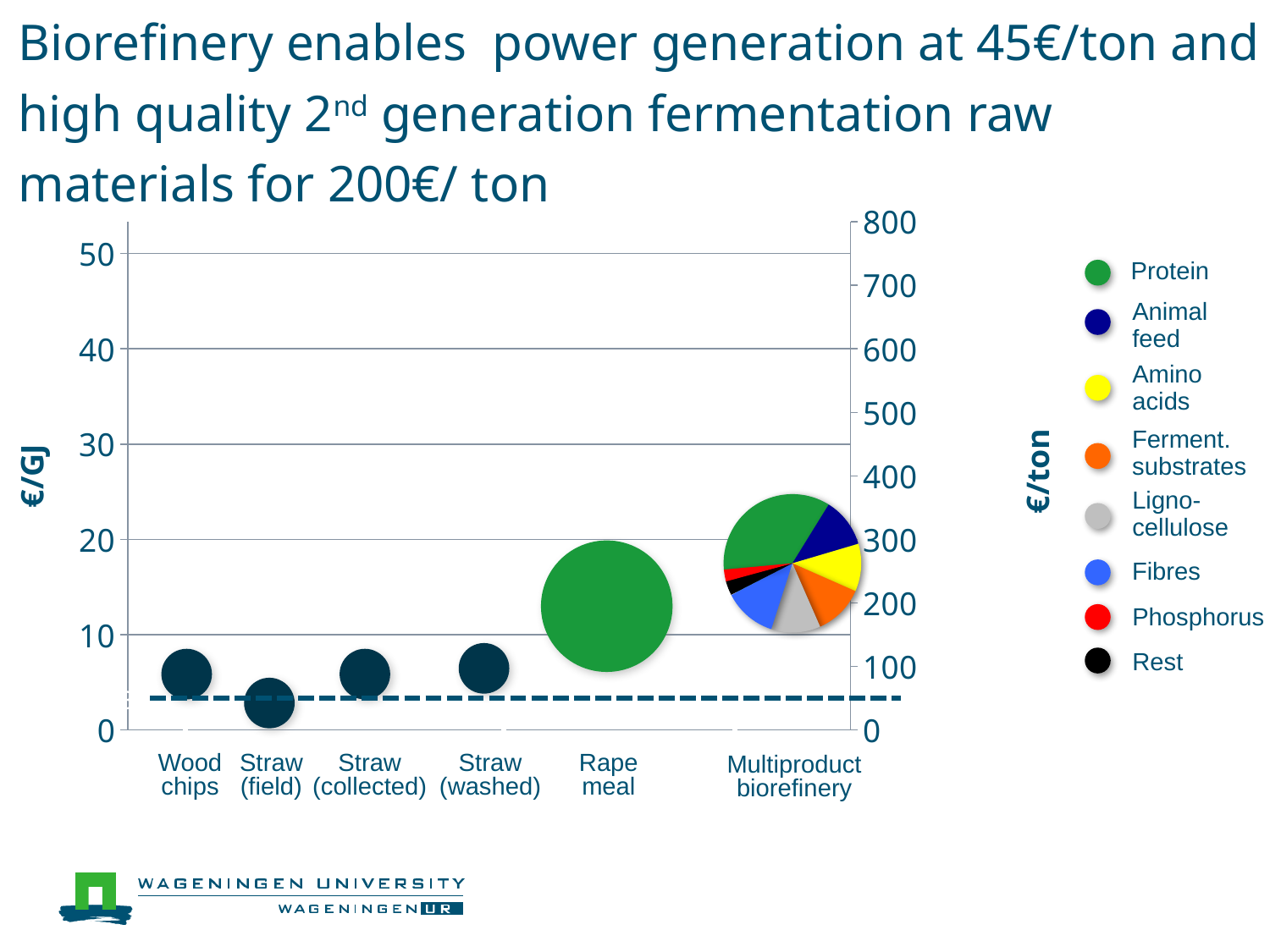
Which category has the highest value on the €/GJ axis? Multiproduct biorefinery What kind of chart is shown on the slide? bubble chart Is the value for Straw (field) greater or less than 10 €/GJ? less Which has the larger value, Rape meal or Wood chips? Rape meal What is the label of the right vertical axis? €/ton Is the value for Wood chips greater or less than 10 €/GJ? less What is the label of the left vertical axis? €/GJ Which category has the lowest value on the €/GJ axis? Straw (field) How many entries does the legend list? 8 Is the value for Rape meal greater or less than 10 €/GJ? greater How many categories are shown on the x axis of the chart? 6